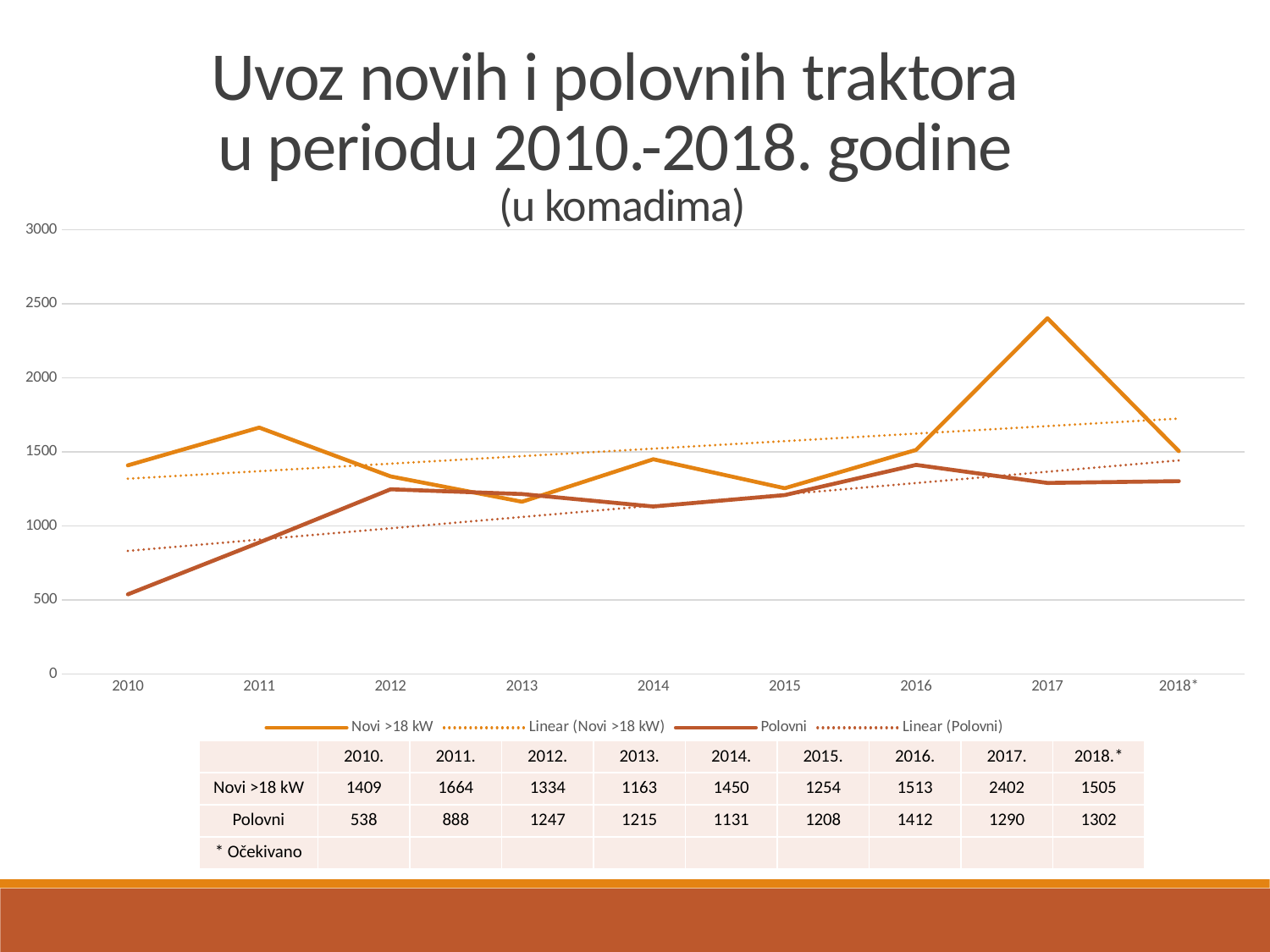
How many entries does the legend list? 4 What is the value for Novi >18 kW in 2017? 2402 In which year is the Novi >18 kW series highest? 2017 What kind of chart is shown on the slide? line chart Which is larger in 2012, Novi >18 kW or Polovni? Novi >18 kW How many years are shown on the x axis? 9 What is the difference between Novi >18 kW and Polovni in 2017? 1112 Which is larger in 2013, Novi >18 kW or Polovni? Polovni In which year is the Polovni series lowest? 2010 Is the value for Novi >18 kW in 2017 greater or less than 2000? greater Does the Polovni series rise or fall from 2010 to 2012? rise What is the value for Polovni in 2010? 538